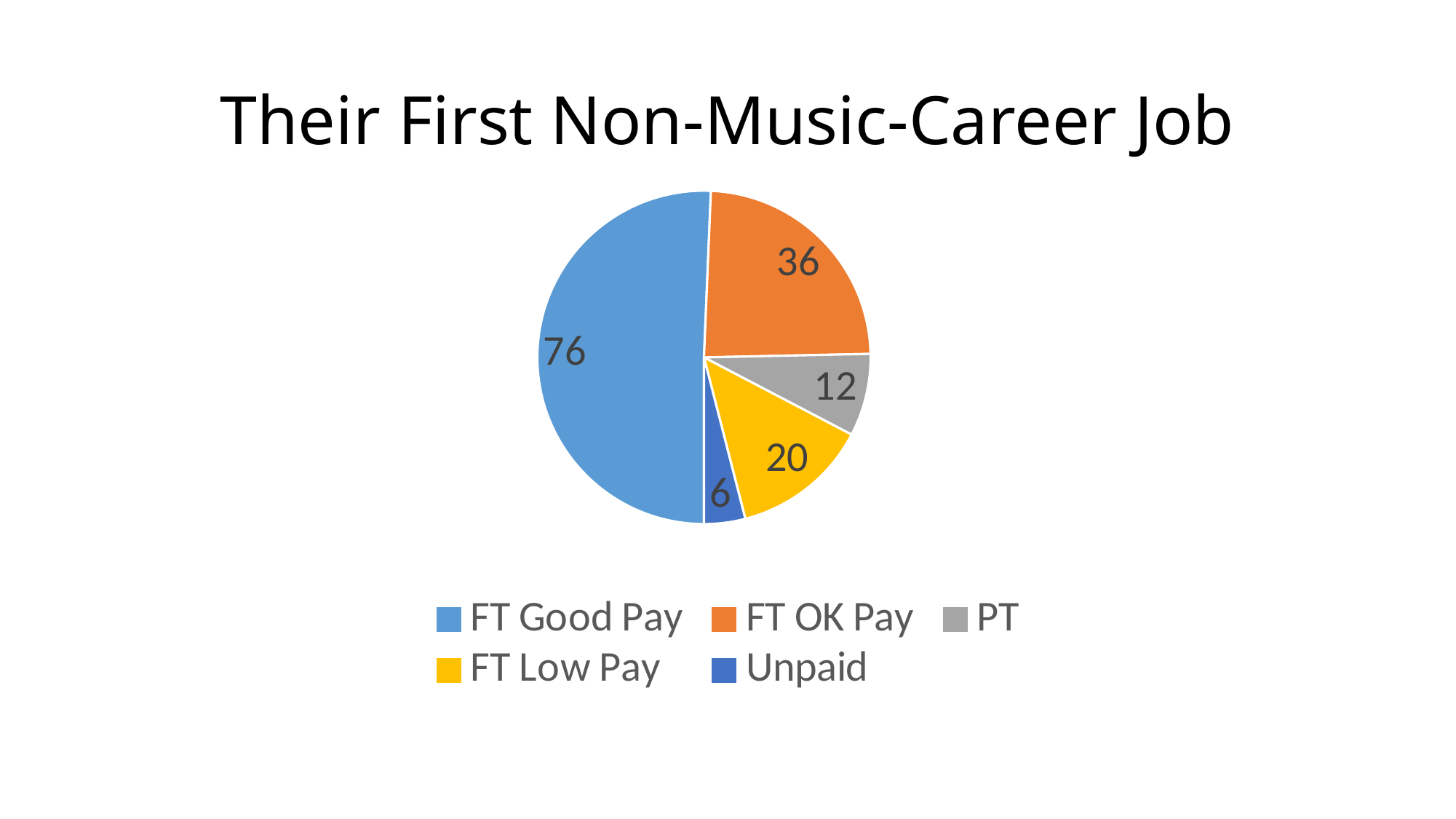
What is the value for Unpaid? 6 What is the value for PT? 12 Which category has the smallest slice? Unpaid What share of the pie does FT OK Pay represent? 24% What kind of chart is shown on the slide? pie chart Which is larger, FT Low Pay or PT? FT Low Pay What is the value for FT Good Pay? 76 Which category has the largest slice? FT Good Pay What is the title of the chart? Their First Non-Music-Career Job What is the value for FT OK Pay? 36 How many categories does the pie chart have? 5 What is the difference between the values for FT Good Pay and FT OK Pay? 40